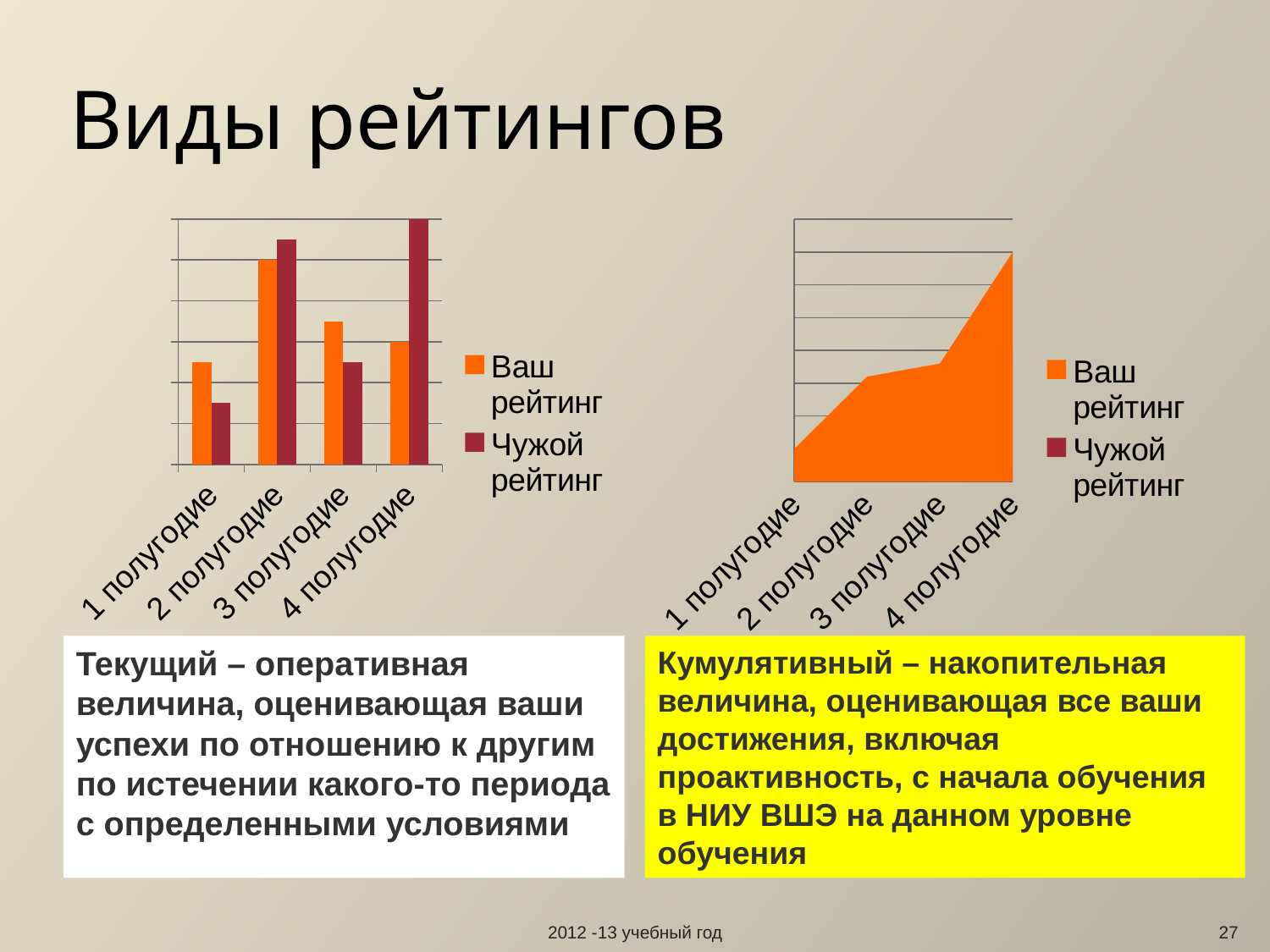
In the area chart on the right, what are the two legend entries? Ваш рейтинг, Чужой рейтинг In the bar chart on the left, for 3 полугодие, which is larger: Ваш рейтинг or Чужой рейтинг? Ваш рейтинг In the bar chart on the left, how many categories are shown on the x axis? 4 In the bar chart on the left, which category has the highest value for Ваш рейтинг? 2 полугодие In the bar chart on the left, which category has the lowest value for Чужой рейтинг? 1 полугодие In the bar chart on the left, which category has the highest value for Чужой рейтинг? 4 полугодие What kind of chart is the chart on the right of the slide? Area chart In the bar chart on the left, how many series does the legend list? 2 In the bar chart on the left, for 2 полугодие, which is larger: Ваш рейтинг or Чужой рейтинг? Чужой рейтинг What kind of chart is the chart on the left of the slide? Bar chart In the area chart on the right, do the values for Ваш рейтинг rise or fall from 1 полугодие to 4 полугодие? Rise In the bar chart on the left, which category has the lowest value for Ваш рейтинг? 1 полугодие